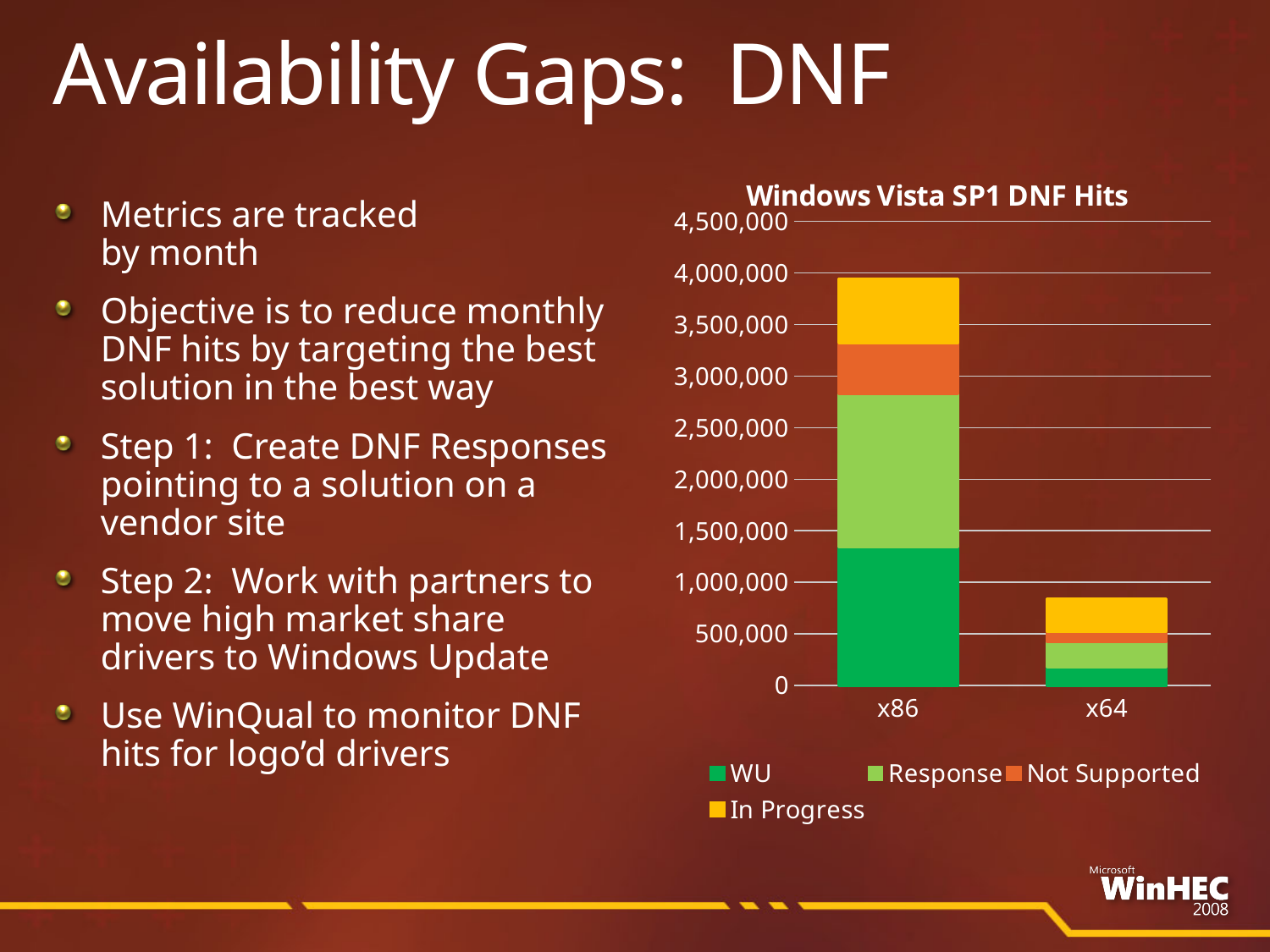
Is the WU segment of the x86 bar greater or less than 1,000,000? greater Is the total value of the x86 bar greater or less than 3,500,000? greater Which series is shown in yellow in the chart legend? In Progress What type of chart is shown on the slide? Stacked bar chart Is the total value of the x64 bar greater or less than 500,000? greater Which series is listed first in the chart legend? WU How many series does the chart legend list? 4 What is the title of the chart? Windows Vista SP1 DNF Hits How many categories are shown on the x axis of the chart? 2 Which category has the taller stacked bar, x86 or x64? x86 Which category has the lowest total DNF hits? x64